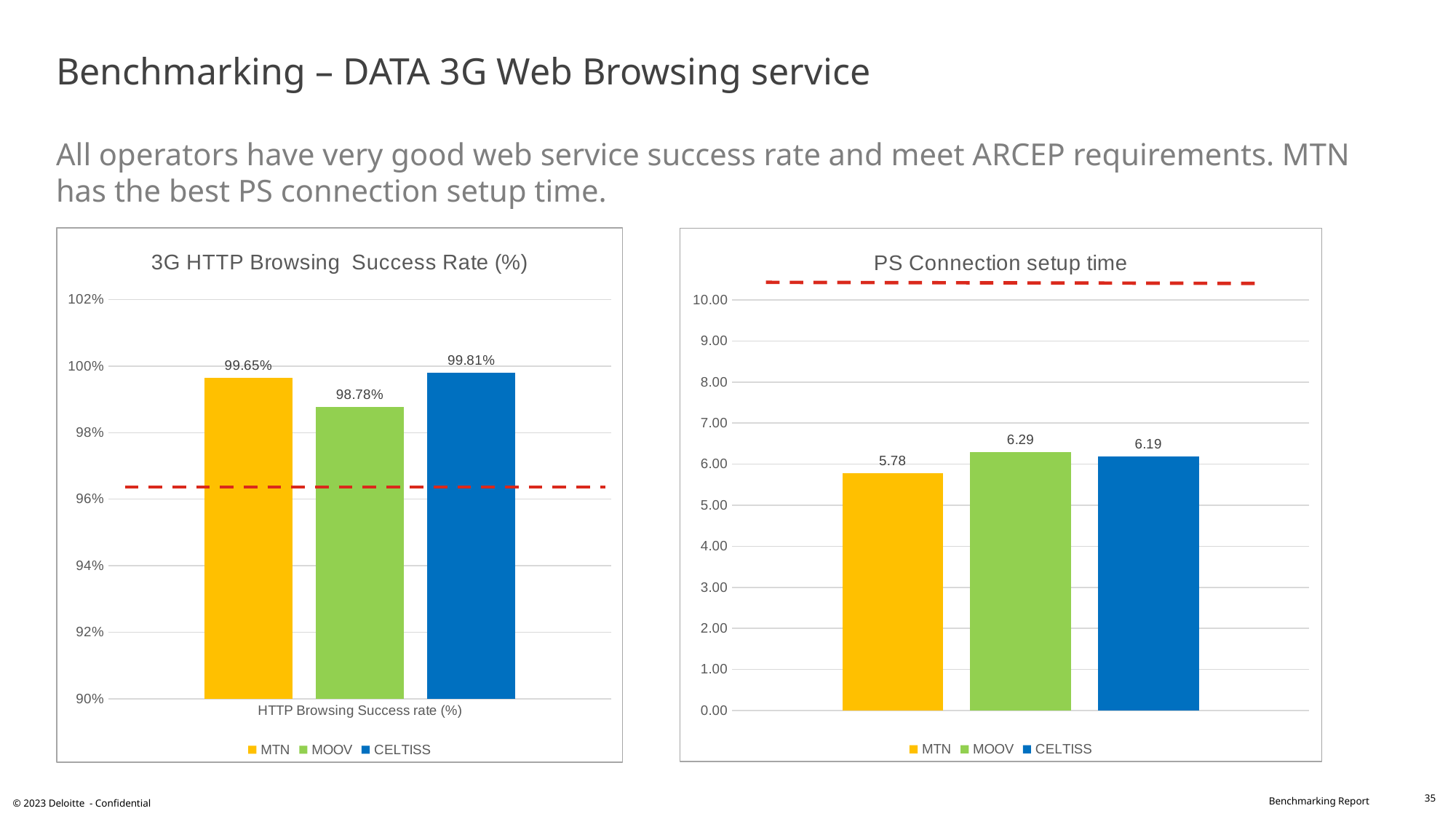
In the 'PS Connection setup time' chart, is the value for MOOV greater or less than 7.00? less In the '3G HTTP Browsing Success Rate (%)' chart, what is the difference between the CELTISS and MOOV values? 1.03% In the 'PS Connection setup time' chart, what is the value for CELTISS? 6.19 How many series does the legend of the 'PS Connection setup time' chart list? 3 In the 'PS Connection setup time' chart, what is the value for MTN? 5.78 In the '3G HTTP Browsing Success Rate (%)' chart, what is the value for MOOV? 98.78% In the 'PS Connection setup time' chart, which operator has the highest setup time? MOOV What kind of chart is the '3G HTTP Browsing Success Rate (%)' chart? Bar chart In the '3G HTTP Browsing Success Rate (%)' chart, what is the value for MTN? 99.65% In the '3G HTTP Browsing Success Rate (%)' chart, which operator has the highest success rate? CELTISS In the 'PS Connection setup time' chart, what is the difference between the MOOV and MTN values? 0.51 In the '3G HTTP Browsing Success Rate (%)' chart, which operator has the lowest success rate? MOOV